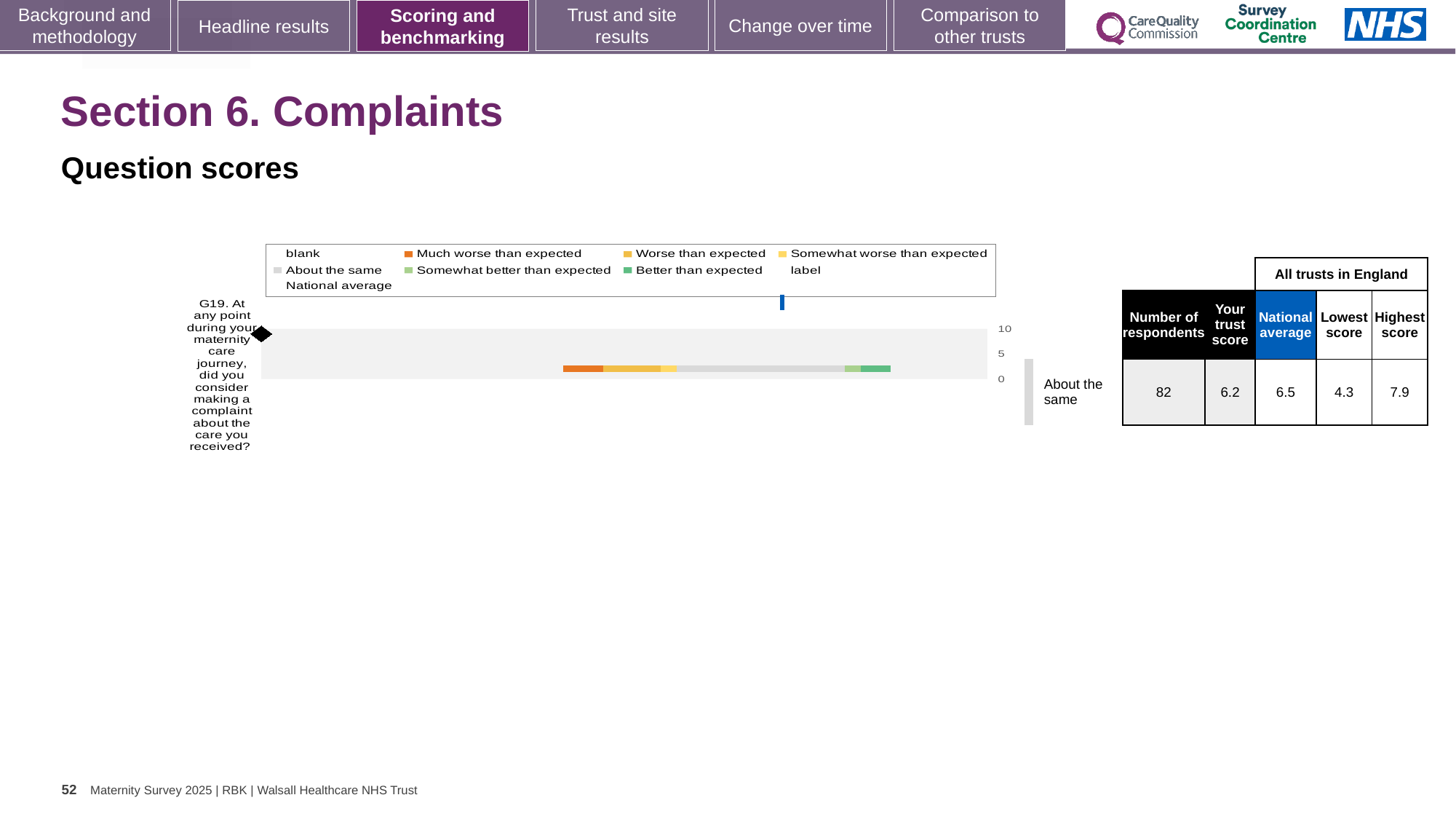
In the table next to the chart, what is the lowest score among all trusts in England for question G19? 4.3 What kind of chart is shown on the slide? bar chart What is the difference between the highest score and the lowest score for question G19? 3.6 What benchmark category label is shown to the right of the chart for question G19? About the same In the table next to the chart, what is the national average for question G19? 6.5 How many questions (categories) are plotted in the chart? 1 Which is larger for question G19, the trust score or the national average? national average Which question number is plotted in the chart? G19 What is the highest tick value shown on the chart's axis? 10 In the table next to the chart, what is the trust score for question G19? 6.2 In the table next to the chart, what is the highest score among all trusts in England for question G19? 7.9 In the table next to the chart, what is the number of respondents for question G19? 82